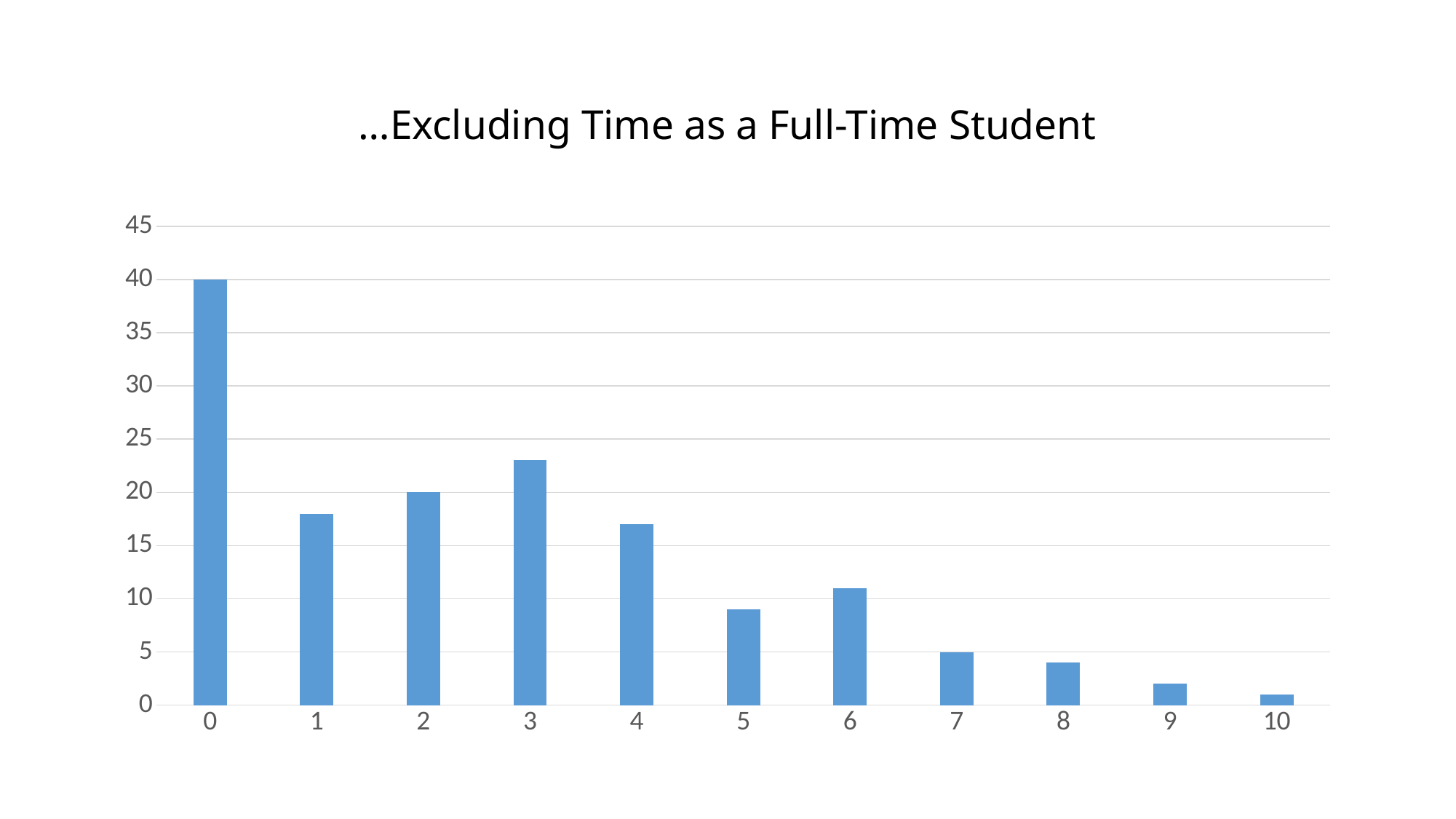
Which has the larger value, category 3 or category 1? 3 Is the value for category 3 greater or less than 20? greater What is the difference between the values for category 0 and category 2? 20 What kind of chart is shown on the slide? bar chart What is the value for category 2? 20 Which category has the highest value? 0 What is the value for category 0? 40 Which category has the lowest value? 10 What is the title of the chart? ...Excluding Time as a Full-Time Student What is the value for category 7? 5 How many categories are shown on the x axis? 11 Is the value for category 5 greater or less than 10? less